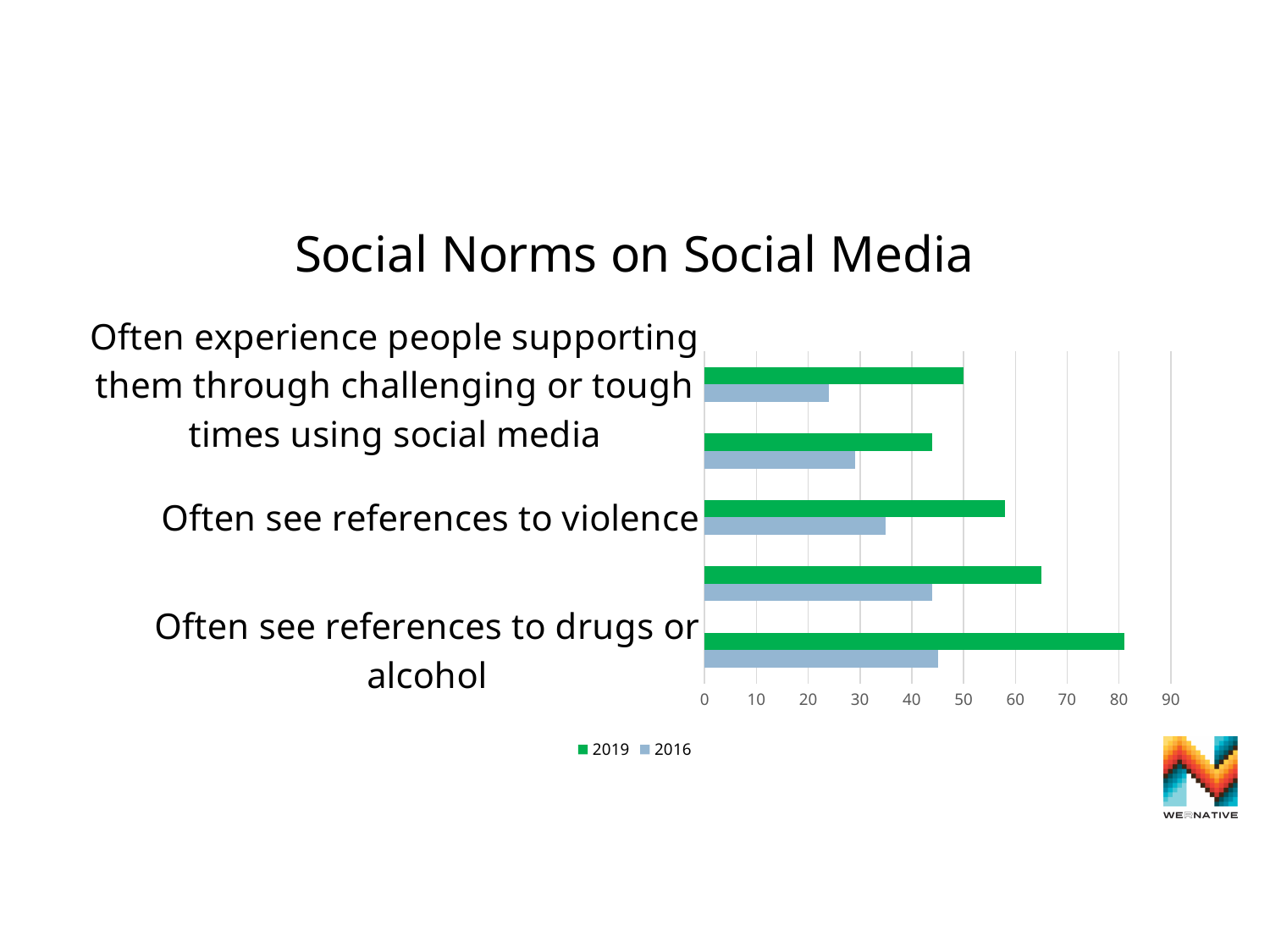
For 'Often see references to drugs or alcohol', which year has the larger value, 2019 or 2016? 2019 For 'Often see references to violence', which year has the larger value, 2019 or 2016? 2019 Is the 2019 value for 'Often see references to drugs or alcohol' greater or less than 70? greater Is the 2016 value for 'Often experience people supporting them through challenging or tough times using social media' greater or less than 30? less Which series is shown in green in the legend? 2019 How many series does the legend list? 2 Is the 2019 value for 'Often see references to violence' greater or less than 50? greater What is the title of the chart? Social Norms on Social Media Which labelled category has the lowest 2016 value? Often experience people supporting them through challenging or tough times using social media What kind of chart is shown on the slide? bar chart Which labelled category has the highest 2019 value? Often see references to drugs or alcohol